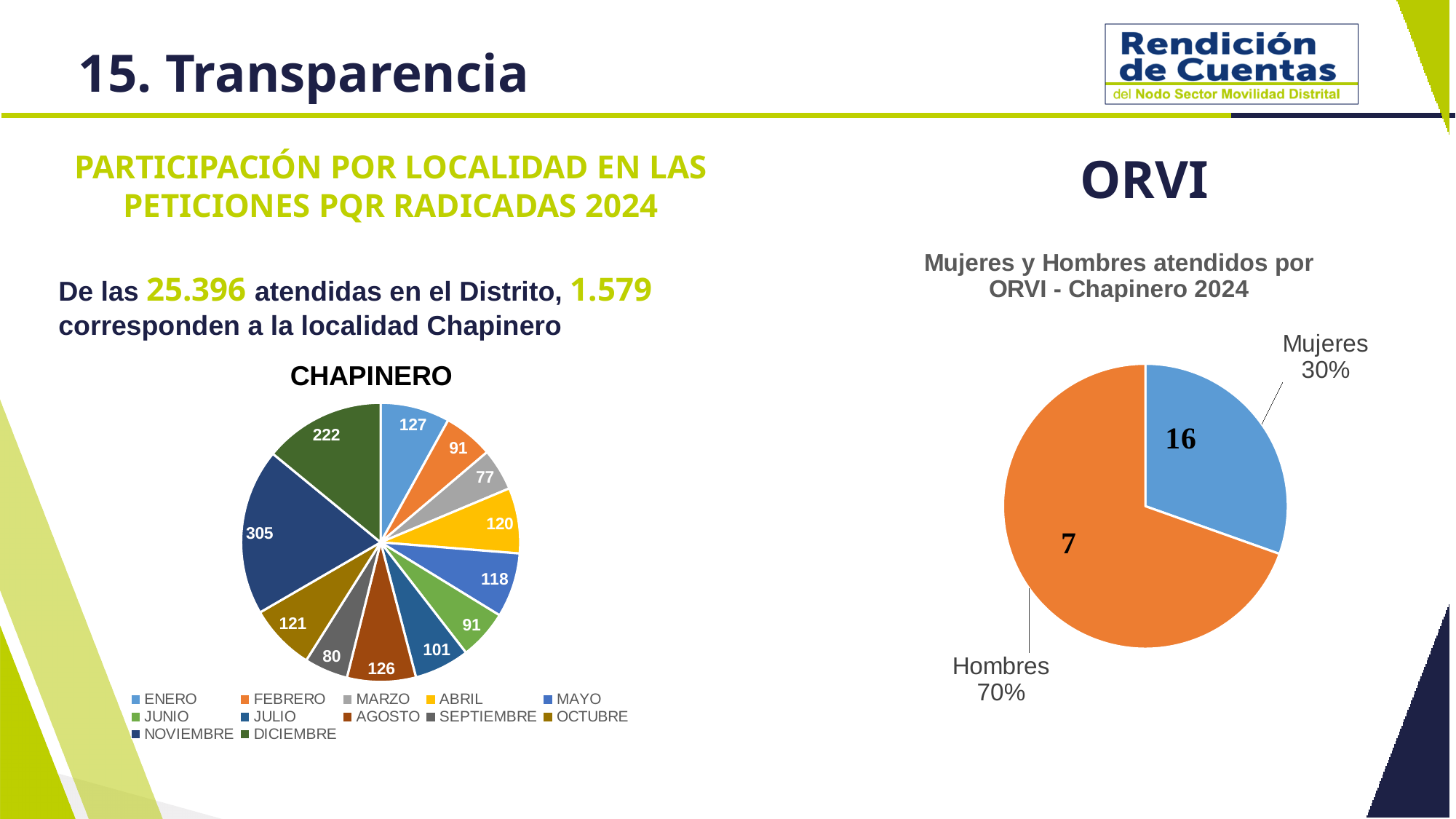
In the CHAPINERO pie chart, what is the value for NOVIEMBRE? 305 How many categories does the CHAPINERO pie chart show? 12 In the CHAPINERO pie chart, what is the value for SEPTIEMBRE? 80 In the CHAPINERO pie chart, which month has the lowest value? MARZO In the CHAPINERO pie chart, which month has the highest value? NOVIEMBRE In the CHAPINERO pie chart, what is the value for OCTUBRE? 121 In the ORVI pie chart on the right, what share of the pie is Mujeres? 30% In the CHAPINERO pie chart, what is the difference between the values for NOVIEMBRE and DICIEMBRE? 83 What is the title of the pie chart on the right side of the slide? Mujeres y Hombres atendidos por ORVI - Chapinero 2024 What kind of chart is the CHAPINERO chart? Pie chart In the ORVI pie chart on the right, which slice is larger, Mujeres or Hombres? Hombres In the CHAPINERO pie chart, which is larger, the value for ENERO or the value for FEBRERO? ENERO